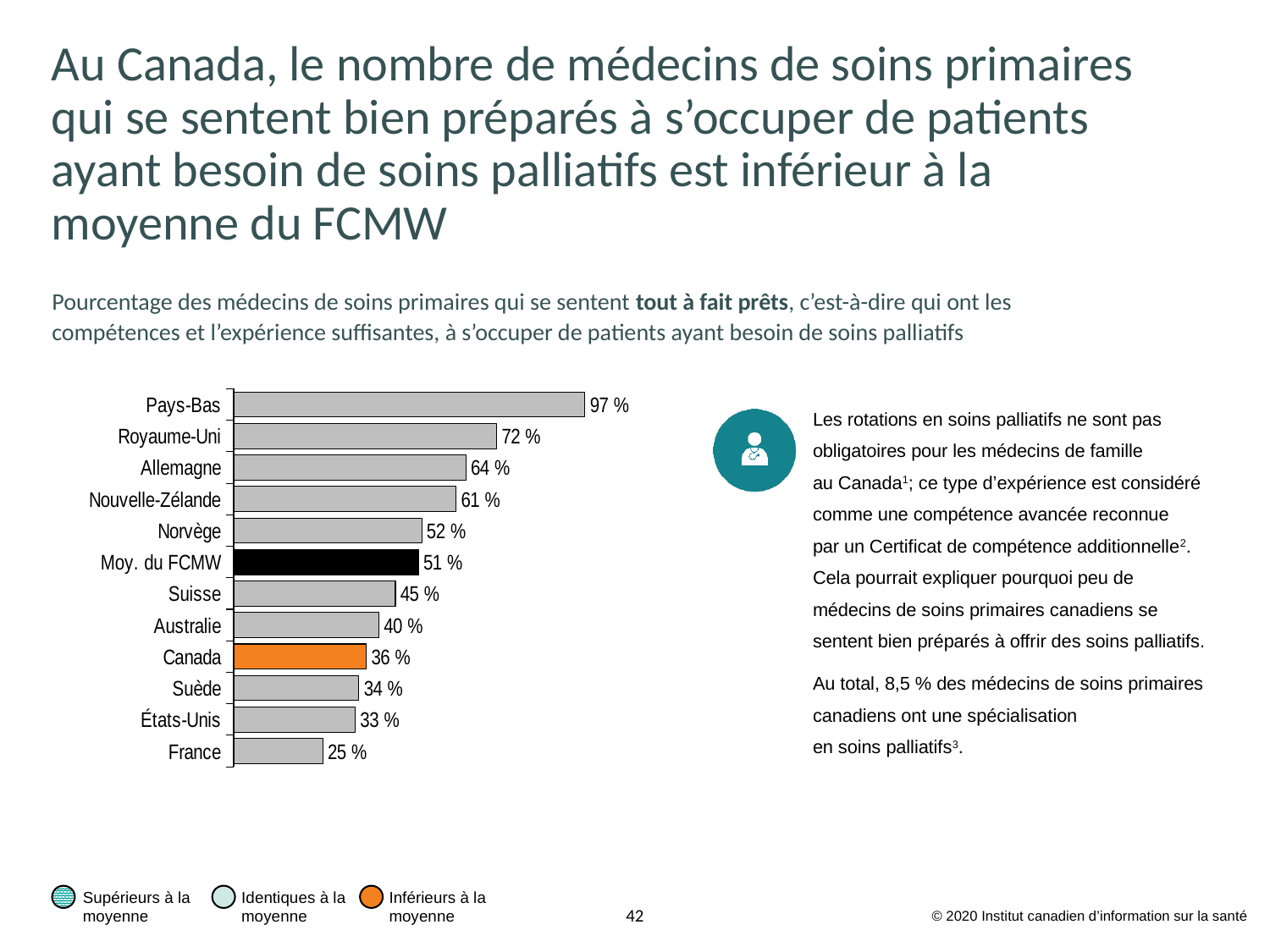
What is the value for Canada? 36 % What is the difference between the value for Pays-Bas and the value for France? 72 % Which country has the lowest value? France What kind of chart is shown on the slide? Bar chart What is the value for Pays-Bas? 97 % What is the value for Suède? 34 % Which has a larger value, Royaume-Uni or Allemagne? Royaume-Uni How many bars are shown in the chart? 12 Which country has the highest value? Pays-Bas What is the difference between the value for Moy. du FCMW and the value for Canada? 15 % What colour is the bar for Canada? Orange What is the value for Moy. du FCMW? 51 %